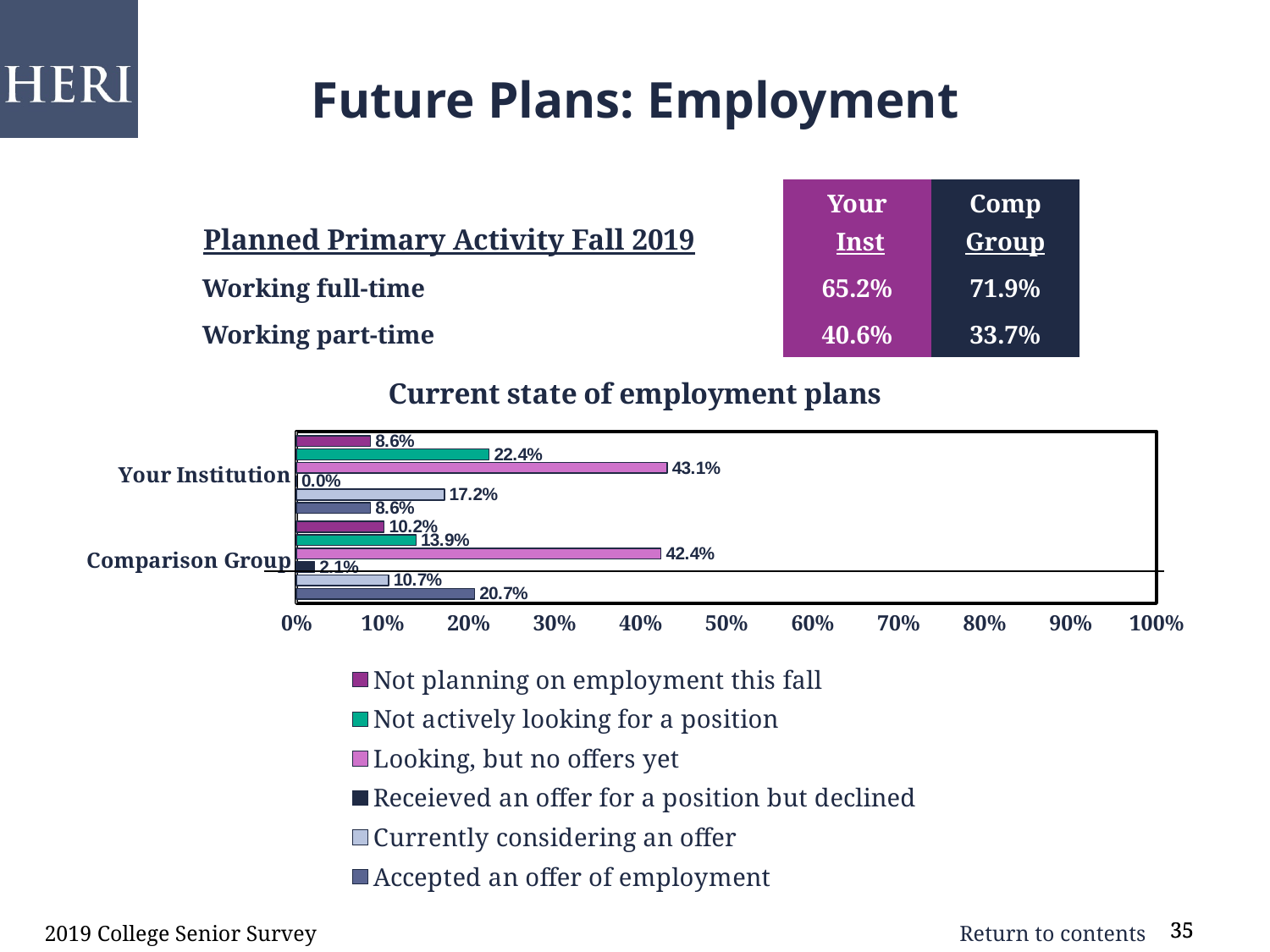
What kind of chart is shown? Bar chart Which series has the lowest value for the Comparison Group? Receieved an offer for a position but declined Which series has the highest value for Your Institution? Looking, but no offers yet What is the value for "Accepted an offer of employment" for the Comparison Group? 20.7% What is the value for "Looking, but no offers yet" for Your Institution? 43.1% What is the difference between Your Institution and the Comparison Group for "Accepted an offer of employment"? 12.1% Is the value for "Looking, but no offers yet" for the Comparison Group greater or less than 40%? greater What is the title of the chart? Current state of employment plans How many series does the legend list? 6 Which is larger for "Currently considering an offer": Your Institution or the Comparison Group? Your Institution What is the value for "Not actively looking for a position" for the Comparison Group? 13.9% What is the value for "Receieved an offer for a position but declined" for Your Institution? 0.0%